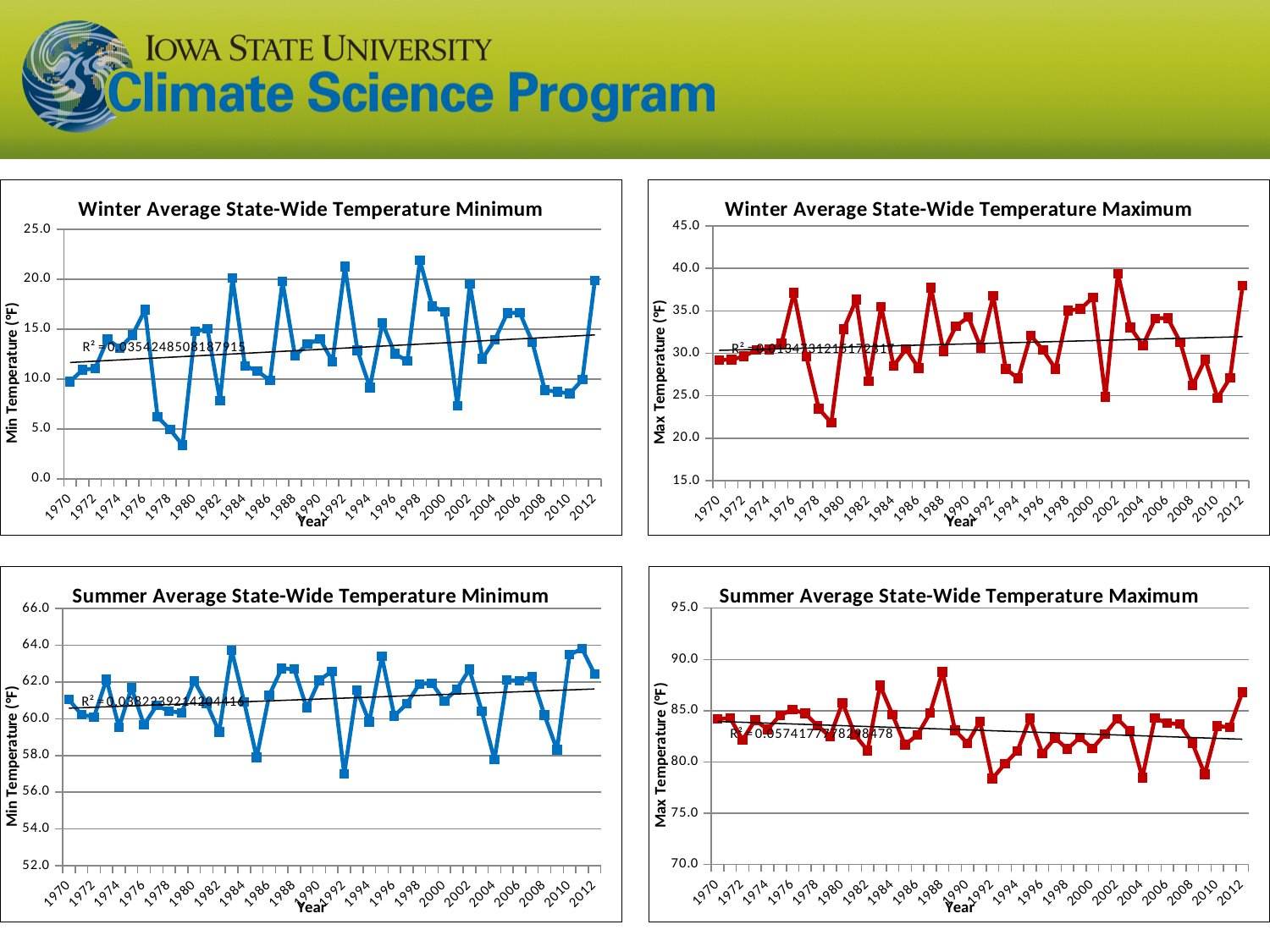
In the "Winter Average State-Wide Temperature Maximum" chart, is the value for 1979 greater or less than 25.0? less How many charts are shown on the slide? 4 In the "Summer Average State-Wide Temperature Minimum" chart, is the value for 1983 greater or less than 62.0? greater In the "Winter Average State-Wide Temperature Minimum" chart, is the value for 1979 greater or less than 5.0? less What kind of chart is the "Winter Average State-Wide Temperature Minimum" chart? line chart In the "Winter Average State-Wide Temperature Minimum" chart, which year has the lowest minimum temperature? 1979 What colour is the data line in the "Winter Average State-Wide Temperature Maximum" chart? red In the "Summer Average State-Wide Temperature Maximum" chart, does the fitted trend line rise or fall from 1970 to 2012? fall